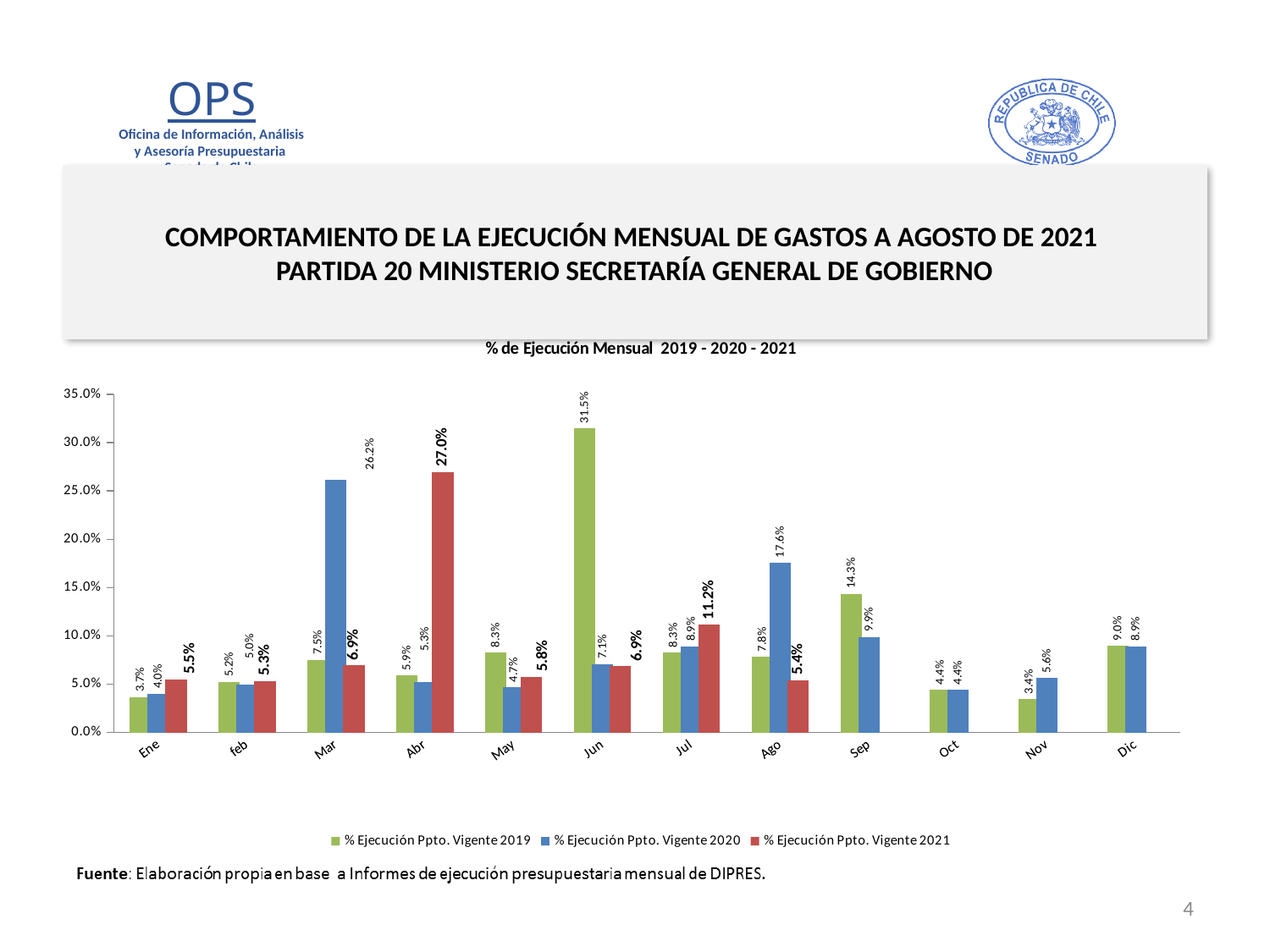
Which month has the lowest value for % Ejecución Ppto. Vigente 2019? Nov How many months are shown on the x axis? 12 How many series does the legend list? 3 What kind of chart is shown on the slide? Bar chart In Jul, which series has the larger value: % Ejecución Ppto. Vigente 2021 or % Ejecución Ppto. Vigente 2019? % Ejecución Ppto. Vigente 2021 What is the value for % Ejecución Ppto. Vigente 2019 in Sep? 14.3% What is the value for % Ejecución Ppto. Vigente 2020 in Mar? 26.2% Which month has the highest value for % Ejecución Ppto. Vigente 2021? Abr What is the difference between the 2020 and 2019 values in Ago? 9.8% What is the value for % Ejecución Ppto. Vigente 2021 in Abr? 27.0% Which month has the highest value for % Ejecución Ppto. Vigente 2019? Jun What is the title of the chart? % de Ejecución Mensual 2019 - 2020 - 2021